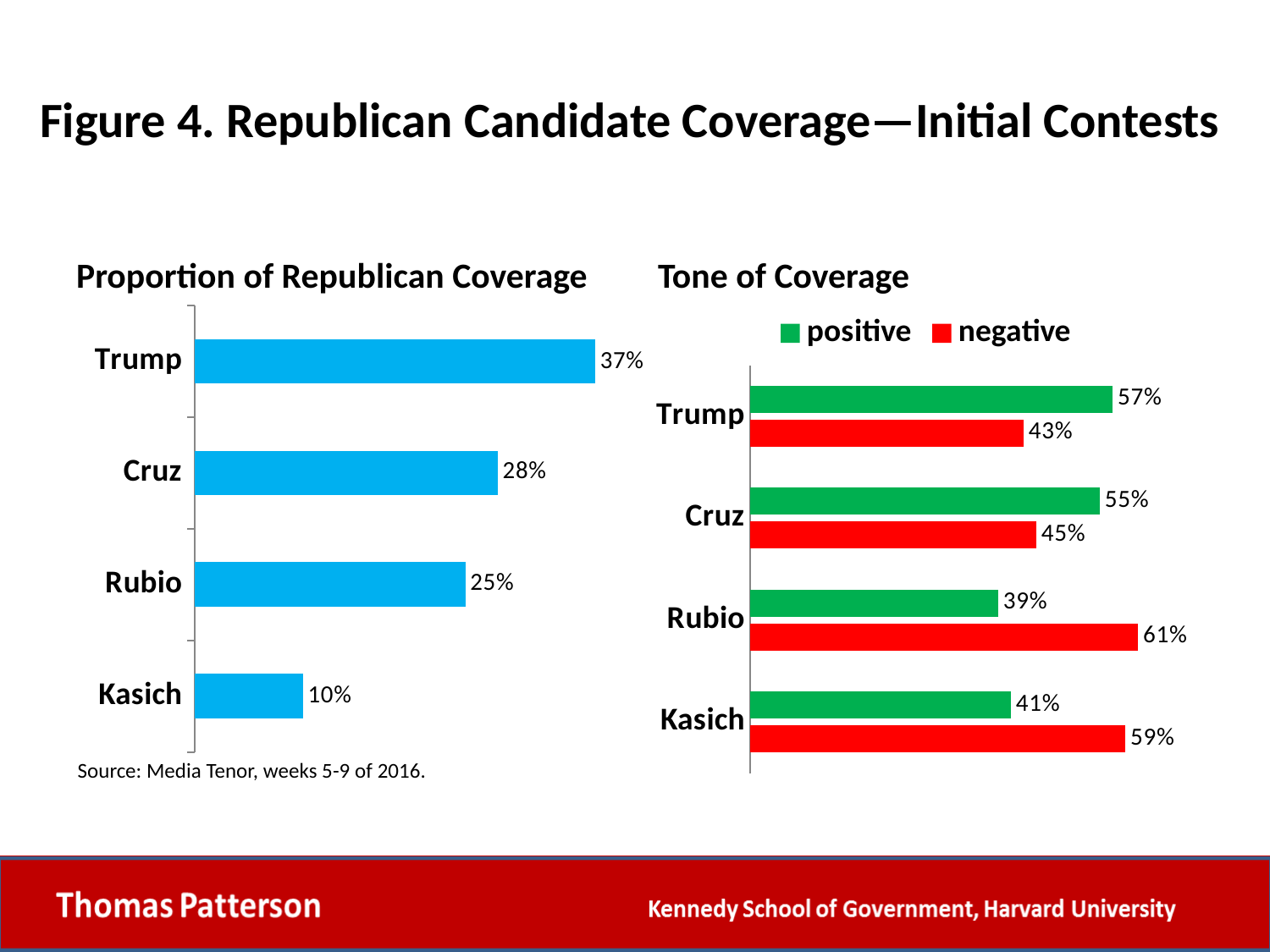
What kind of chart is the 'Proportion of Republican Coverage' chart? bar chart In the 'Tone of Coverage' chart, what is the negative value for Rubio? 61% In the 'Tone of Coverage' chart, which candidate has the highest positive value? Trump In the 'Proportion of Republican Coverage' chart, what is the value for Cruz? 28% In the 'Tone of Coverage' chart, is Cruz's positive value or negative value larger? positive How many series does the legend of the 'Tone of Coverage' chart list? 2 In the 'Proportion of Republican Coverage' chart, what is the difference between Trump's and Rubio's values? 12% In the 'Proportion of Republican Coverage' chart, which candidate has the highest proportion of coverage? Trump In the 'Tone of Coverage' chart, what is the difference between Kasich's negative and positive values? 18% In the 'Tone of Coverage' chart, what is the positive value for Kasich? 41% In the 'Proportion of Republican Coverage' chart, which candidate has the lowest proportion of coverage? Kasich In the 'Proportion of Republican Coverage' chart, how many candidates are shown? 4